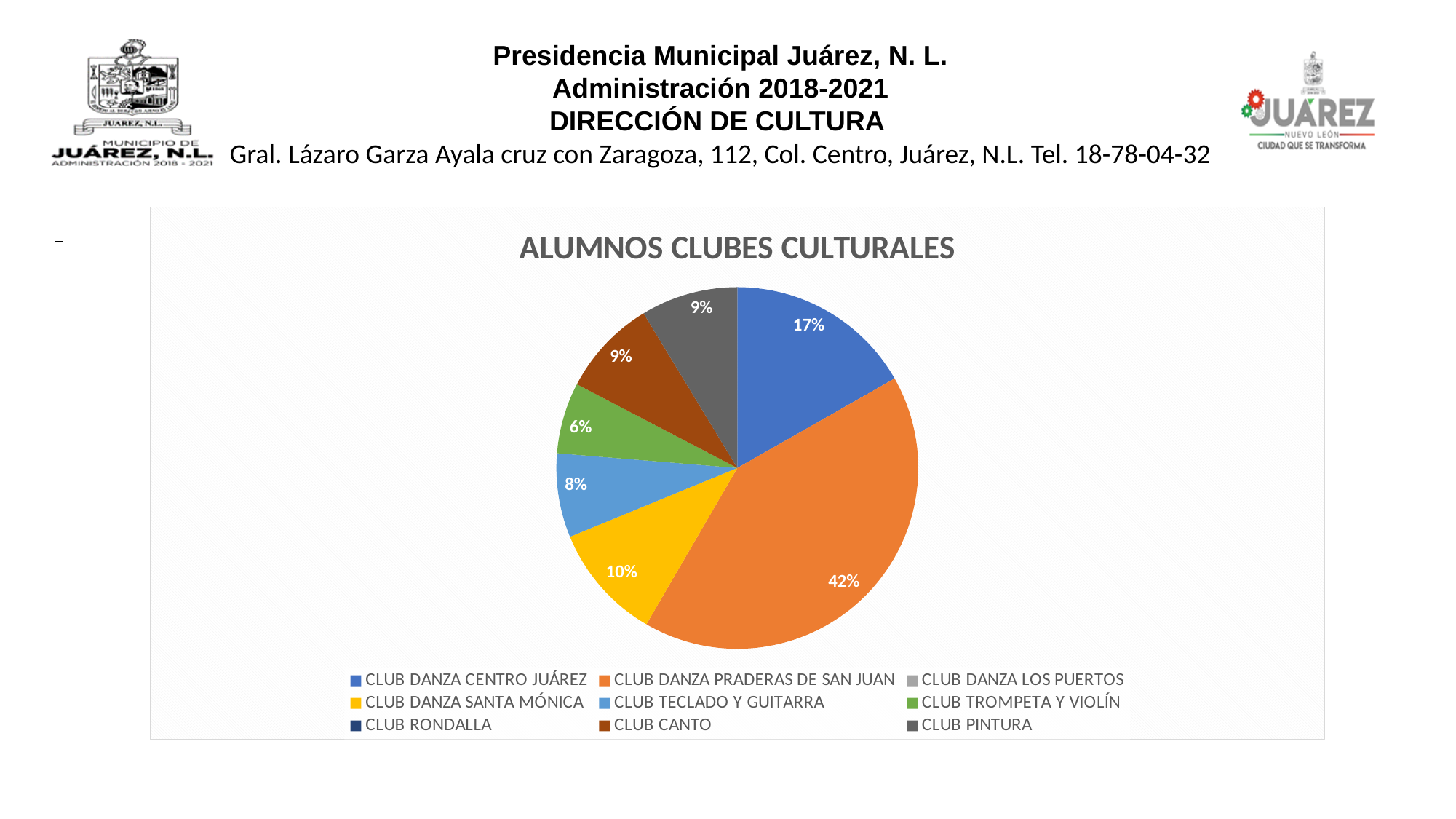
What is the difference in percentage points between the share for CLUB DANZA PRADERAS DE SAN JUAN and the share for CLUB DANZA CENTRO JUÁREZ? 25 What share of the pie does CLUB DANZA SANTA MÓNICA have? 10% What type of chart is shown on the slide? pie chart What share of the pie does CLUB DANZA PRADERAS DE SAN JUAN have? 42% What is the title of the chart? ALUMNOS CLUBES CULTURALES How many entries does the legend list? 9 Which club has the largest share of the pie? CLUB DANZA PRADERAS DE SAN JUAN What share of the pie does CLUB CANTO have? 9% Which is larger, the share for CLUB DANZA CENTRO JUÁREZ or the share for CLUB DANZA SANTA MÓNICA? CLUB DANZA CENTRO JUÁREZ